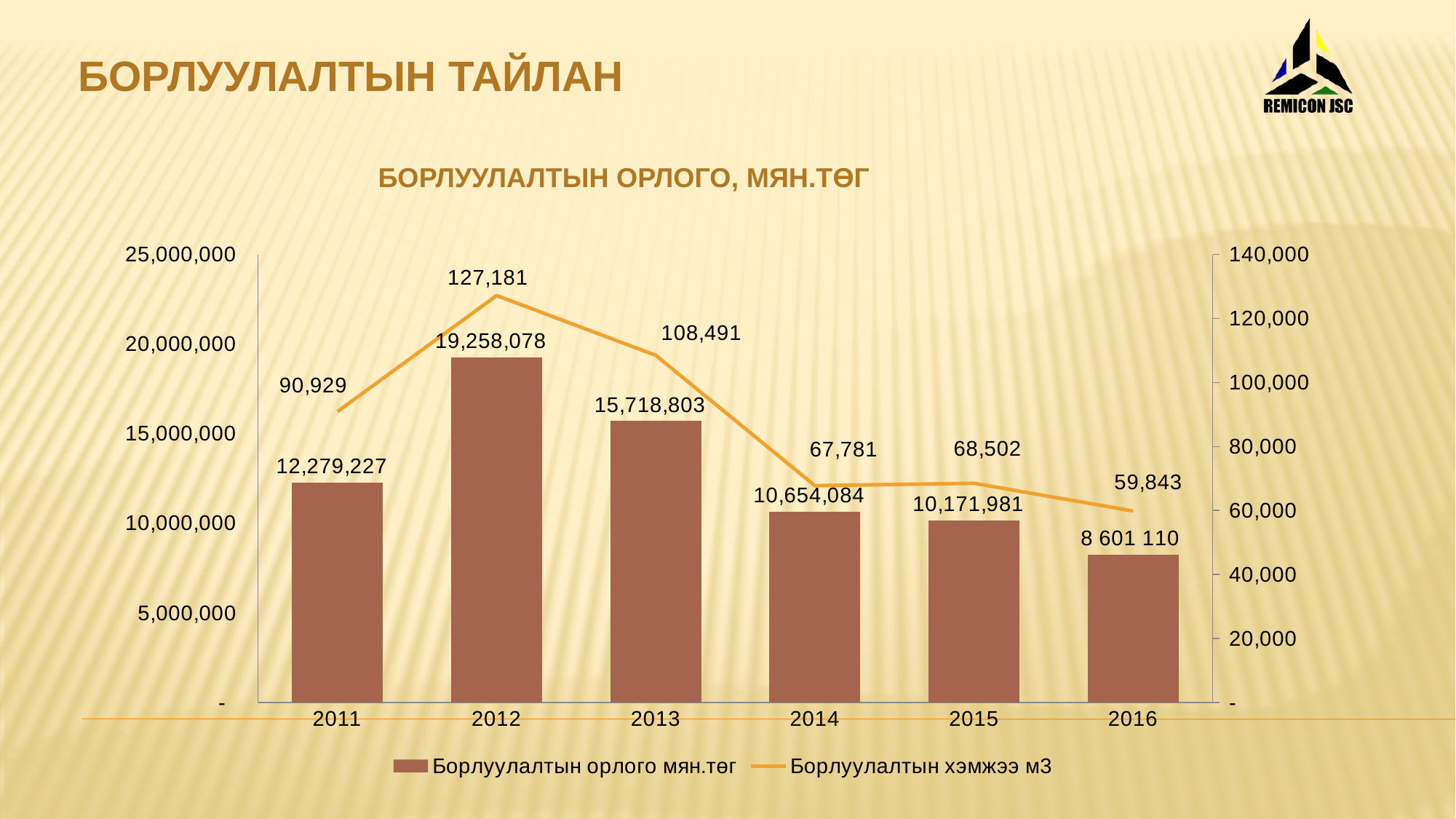
Which year has the highest sales revenue? 2012 How many series does the legend list? 2 What is the difference in sales revenue between 2012 and 2013? 3,539,275 Is the sales revenue for 2016 greater or less than 10,000,000? less What is the trend of sales revenue from 2012 to 2016? falling Which year has the larger sales revenue, 2011 or 2013? 2013 By how much did the sales volume (м3) increase from 2011 to 2012? 36,252 What is the sales revenue value shown for 2016? 8 601 110 What is the sales revenue (Борлуулалтын орлого мян.төг) for 2012? 19,258,078 What is the sales volume (Борлуулалтын хэмжээ м3) for 2014? 67,781 How many years are shown on the x axis? 6 Which year has the lowest sales volume (м3)? 2016